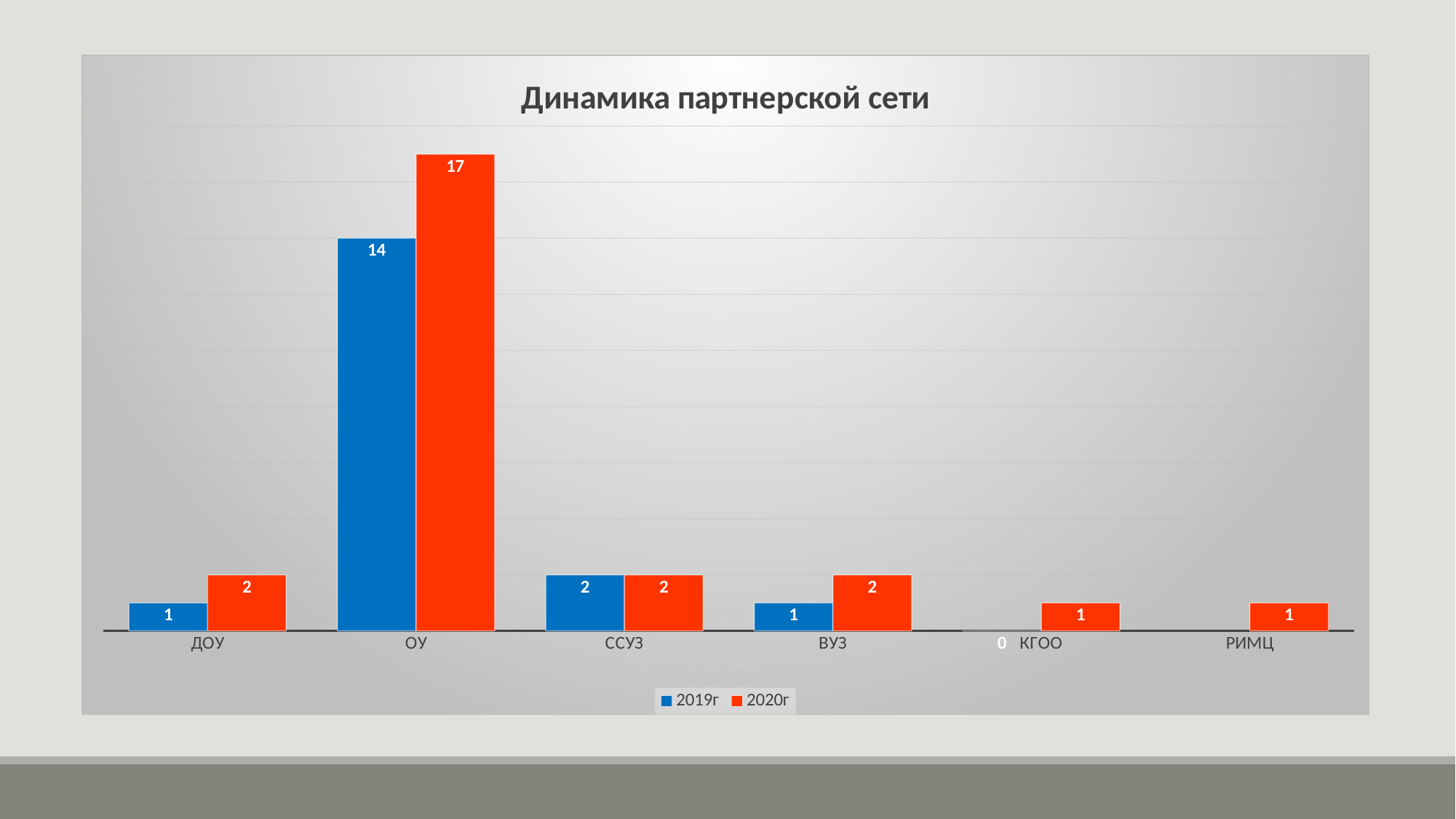
Which category has the highest value in the 2020г series? ОУ What is the difference between the 2020г and 2019г values for ОУ? 3 Which is larger for ВУЗ: the 2019г value or the 2020г value? 2020г How many series does the legend list? 2 What is the value for ДОУ in the 2020г series? 2 What is the value for КГОО in the 2019г series? 0 What is the value for ОУ in the 2019г series? 14 What is the value for ОУ in the 2020г series? 17 How many categories are shown on the x axis? 6 What is the title of the chart? Динамика партнерской сети Which category has the lowest value in the 2019г series? КГОО What kind of chart is shown on the slide? Bar chart